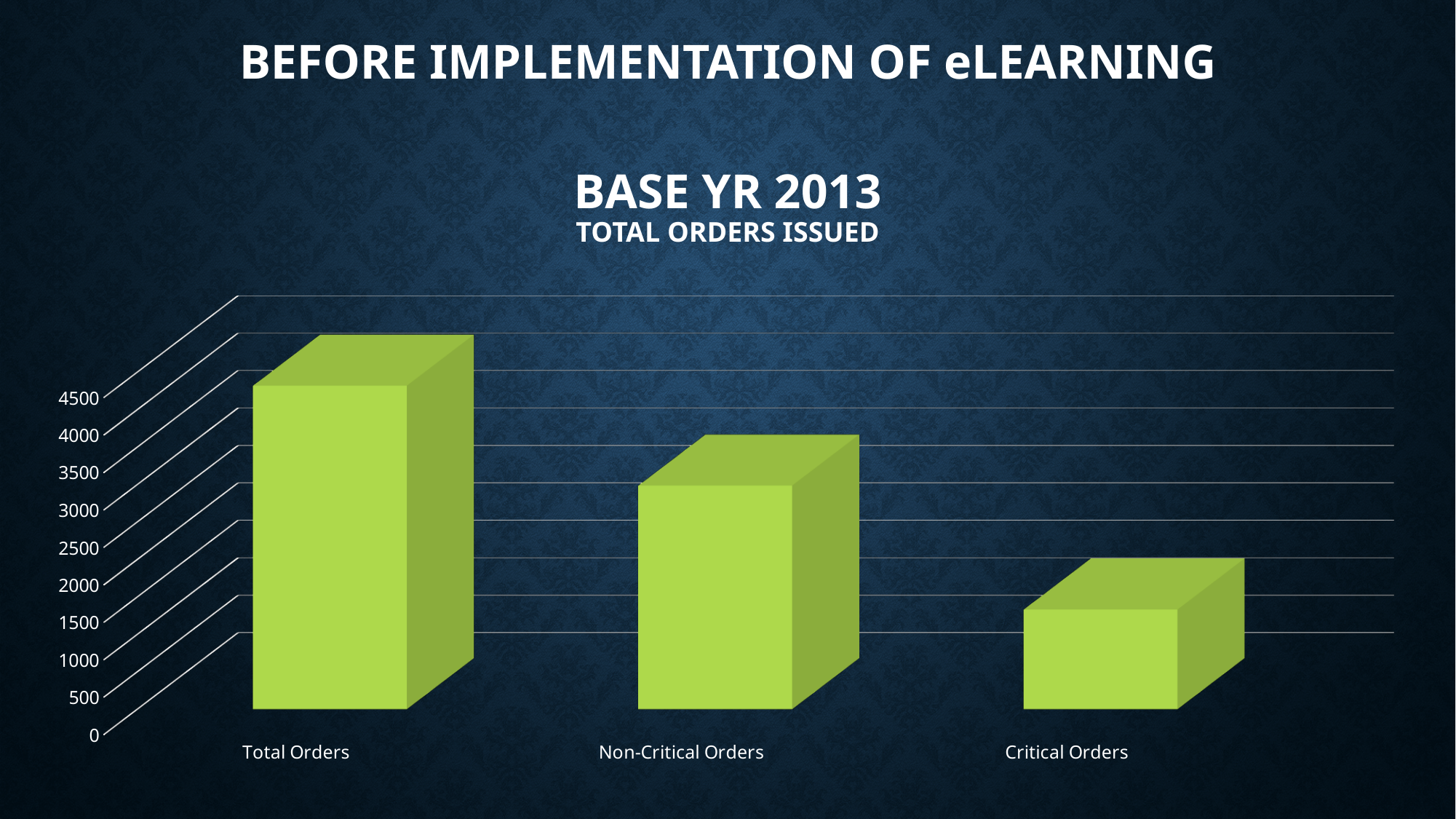
Is the value for Critical Orders greater or less than 2500? less Do the values rise or fall moving from left to right across the categories? fall Is the value for Critical Orders greater or less than 1000? greater How many categories are plotted in the chart? 3 What kind of chart is shown on the slide? bar chart Is the value for Non-Critical Orders greater or less than 4000? less Which category has the highest value? Total Orders Which category has the lowest value? Critical Orders What base year does the chart heading refer to? 2013 Which is larger, Non-Critical Orders or Critical Orders? Non-Critical Orders